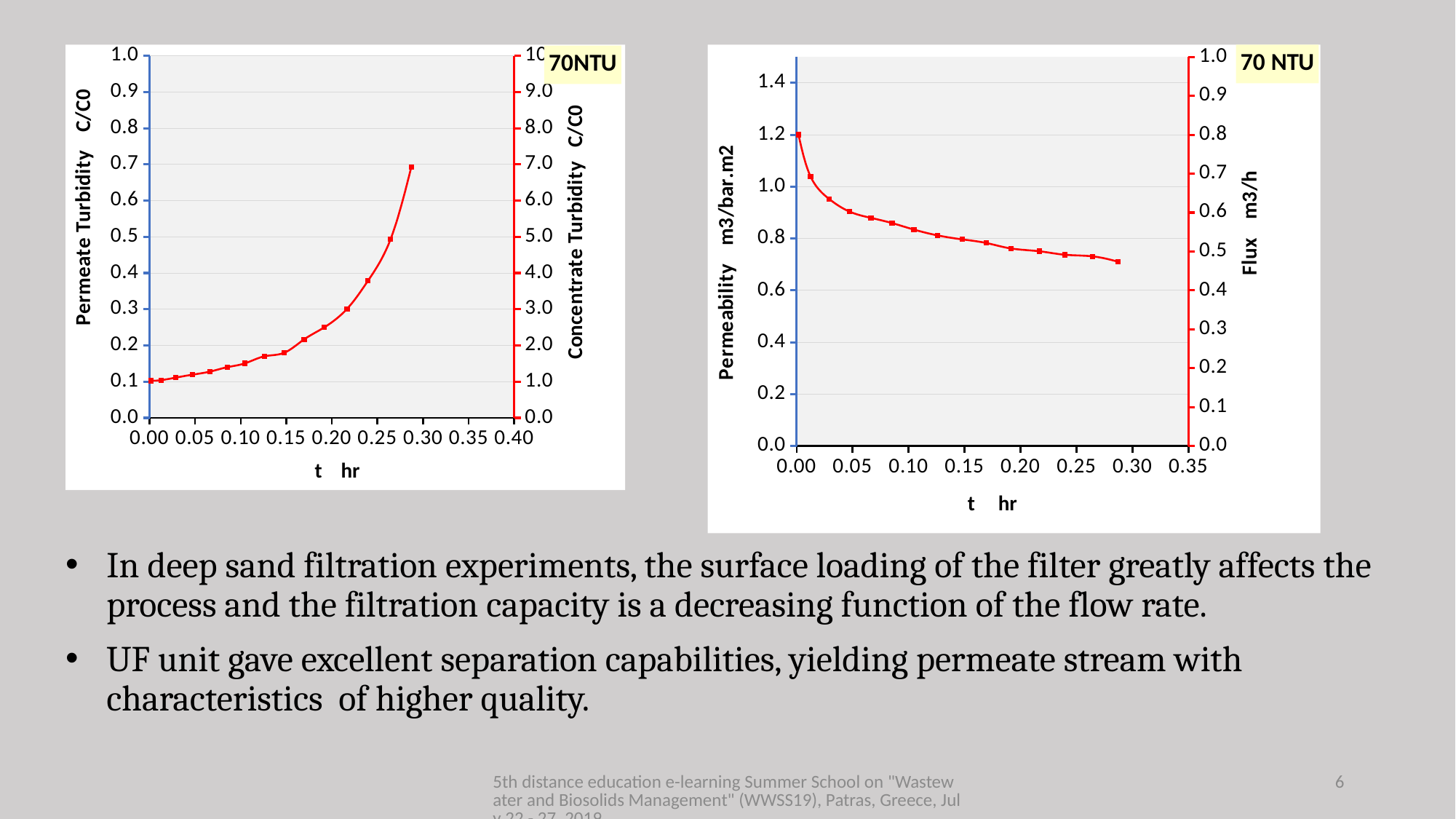
In the right chart (Permeability), do the values rise or fall as t increases? fall What is the title of the secondary (right-hand) y-axis of the right chart? Flux m3/h What kind of chart is the left chart (Permeate Turbidity vs t)? line chart In the left chart (Permeate Turbidity), is the value at the last point (t ≈ 0.29 hr) greater or less than 0.5? greater In the left chart (Permeate Turbidity), do the values rise or fall as t increases? rise In the left chart, which point has the highest Permeate Turbidity value: the first point (t = 0.00) or the last point (t ≈ 0.29)? the last point (t ≈ 0.29) What kind of chart is the right chart (Permeability vs t)? line chart In the right chart (Permeability), is the value at the last point (t ≈ 0.29 hr) greater or less than 0.8? less In the right chart (Permeability), is the value at t = 0.00 hr greater or less than 1.0? greater What is the x-axis title of the right chart (Permeability)? t hr